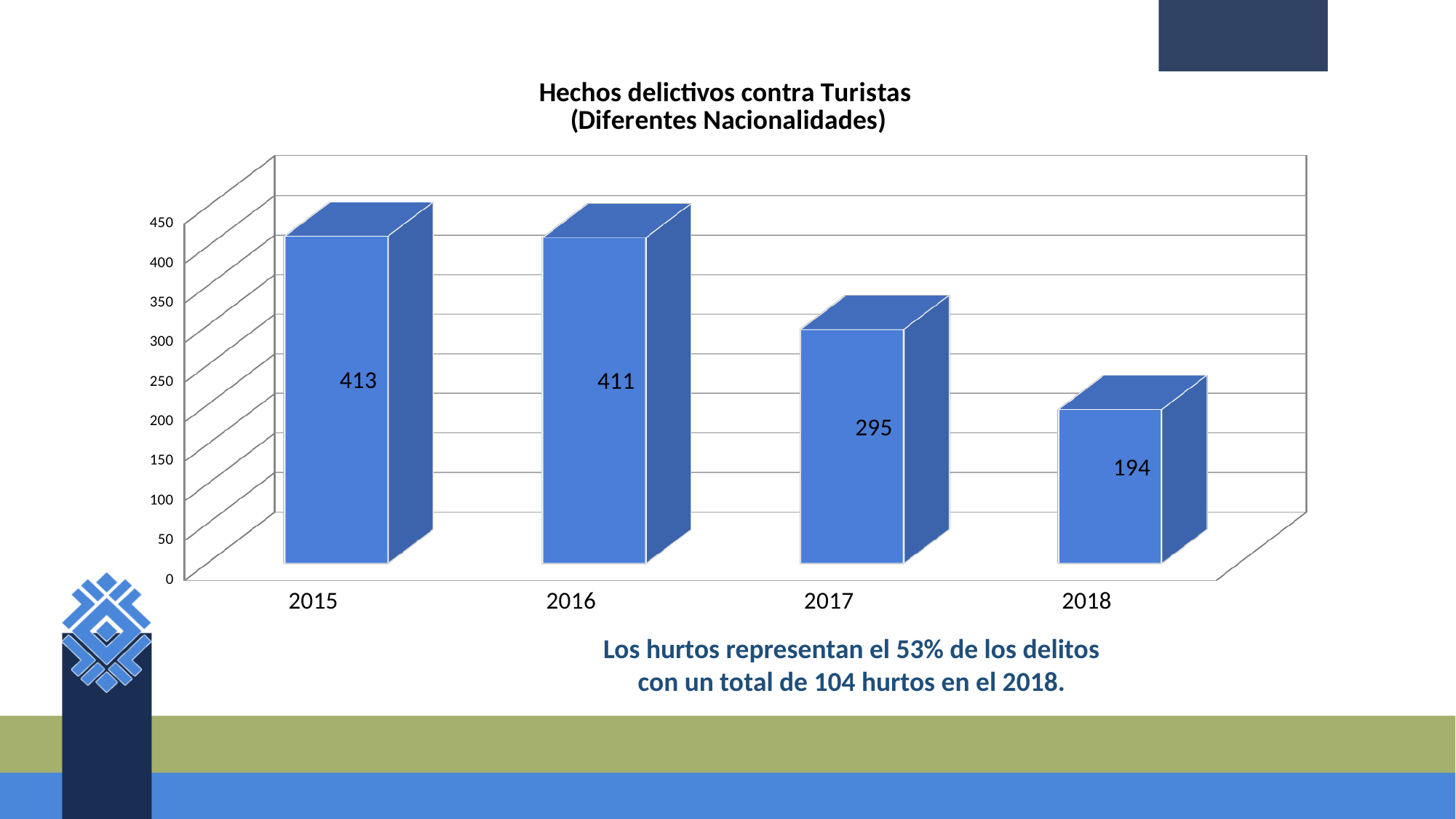
Which year has the lowest value? 2018 What is the difference between the values for 2015 and 2017? 118 What is the value for 2015? 413 What is the value for 2017? 295 Do the values rise or fall from 2015 to 2018? fall What is the difference between the values for 2016 and 2018? 217 Is the value for 2017 greater or less than 250? greater What is the value for 2018? 194 What is the title of the chart? Hechos delictivos contra Turistas (Diferentes Nacionalidades) How many years are shown on the x axis? 4 Which is larger, the value for 2017 or the value for 2018? 2017 What kind of chart is shown on the slide? bar chart